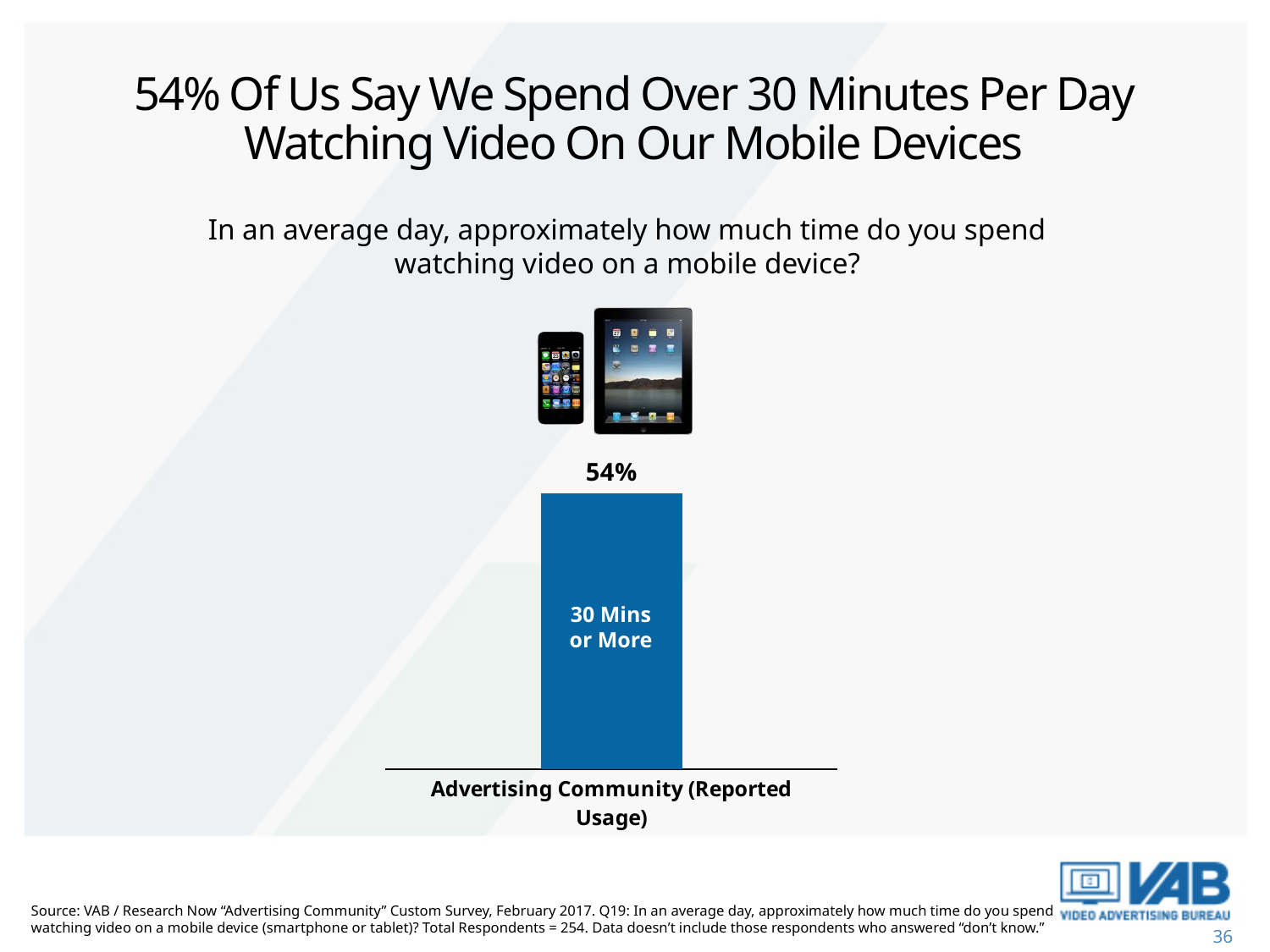
What label is printed inside the blue bar? 30 Mins or More How many bars are plotted in the chart? 1 What kind of chart is shown on the slide? bar chart Is the value for the "30 Mins or More" bar greater or less than 50%? greater What value is shown for the "30 Mins or More" bar for Advertising Community (Reported Usage)? 54% What is the category label on the x axis of the chart? Advertising Community (Reported Usage)